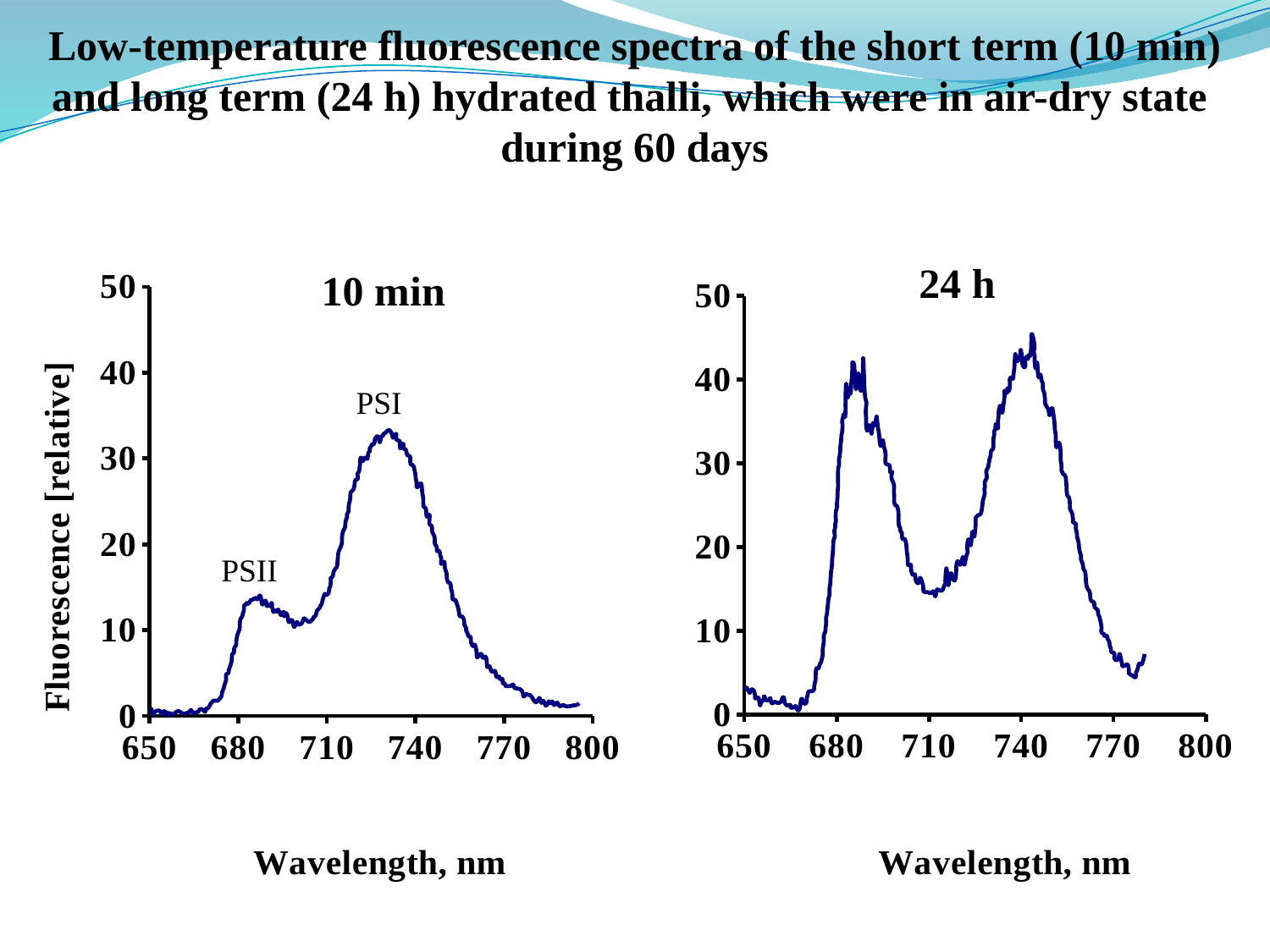
What is the x-axis label of the '24 h' chart? Wavelength, nm In the '24 h' chart, is the peak near 740 nm greater or less than 40? greater In the '24 h' chart, is the peak near 685 nm greater or less than 30? greater What is the y-axis label shown on the left of the '10 min' chart? Fluorescence [relative] In the '10 min' chart, is the value at the right end of the line (near 800 nm) greater or less than 10? less What kind of chart is the '10 min' chart? Line chart In the '10 min' chart, which labelled peak is higher, PSII or PSI? PSI In the '24 h' chart, does the fluorescence rise or fall between 740 nm and 770 nm? fall Is the peak near 740 nm higher in the '10 min' chart or in the '24 h' chart? 24 h